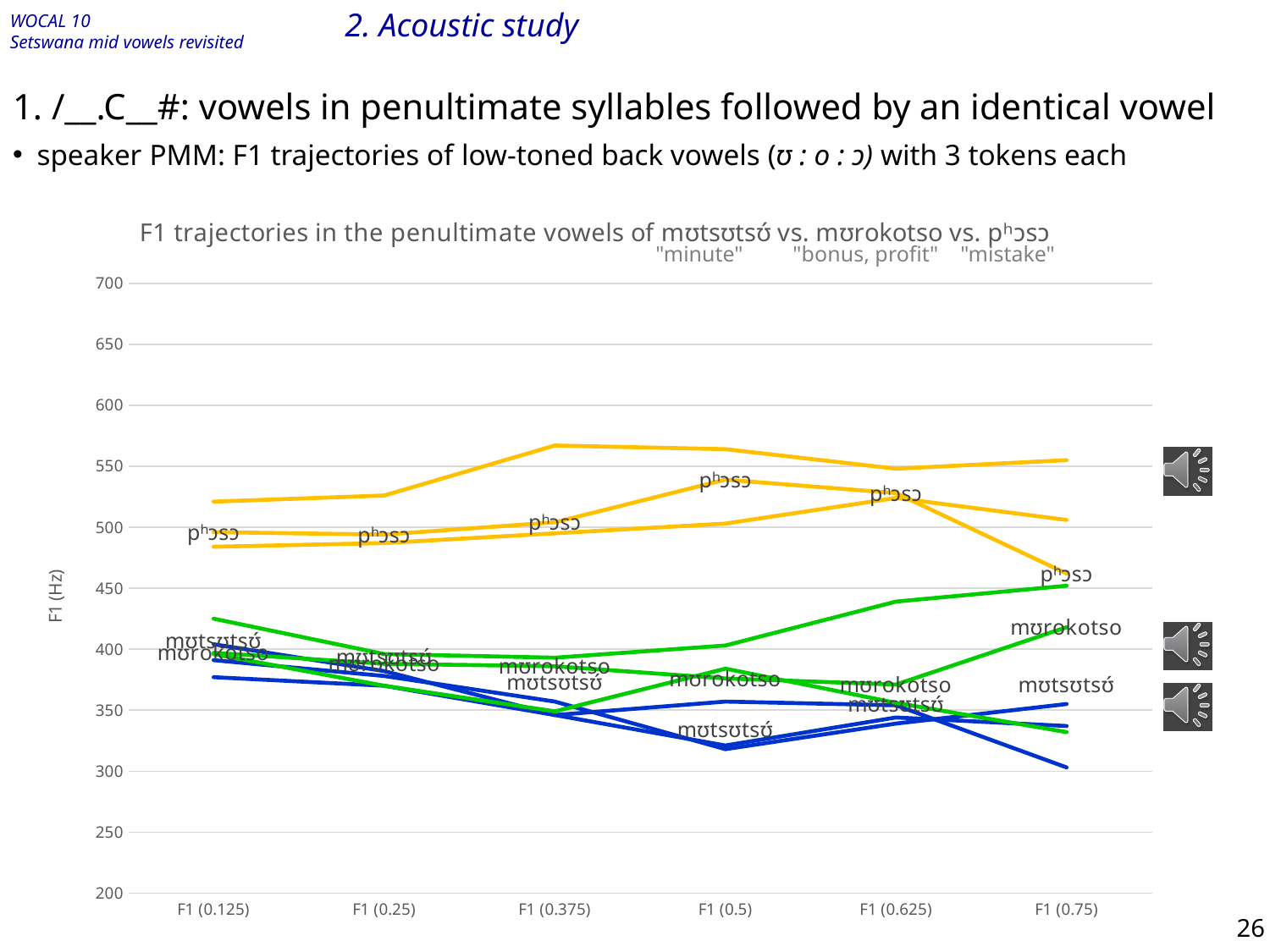
How many time points are shown along the x axis of the F1 trajectories chart? 6 According to the chart title, what is the English gloss of mʊrokotso? "bonus, profit" Does the lowest pʰɔsɔ trajectory rise or fall between F1 (0.625) and F1 (0.75)? fall At F1 (0.5), are the F1 values for pʰɔsɔ higher or lower than those for mʊtsʊtsʊ́? higher Are the F1 values for pʰɔsɔ at F1 (0.375) greater or less than 450? greater Are the F1 values for mʊtsʊtsʊ́ at F1 (0.5) greater or less than 400? less Is the highest pʰɔsɔ value at F1 (0.375) greater or less than 550? greater Does the highest pʰɔsɔ trajectory rise or fall between F1 (0.125) and F1 (0.375)? rise What kind of chart is shown on the slide? line chart Which word has the lowest F1 value at F1 (0.75)? mʊtsʊtsʊ́ What is the label of the y axis of the F1 trajectories chart? F1 (Hz) Which word has the highest F1 values across the trajectories in the chart? pʰɔsɔ